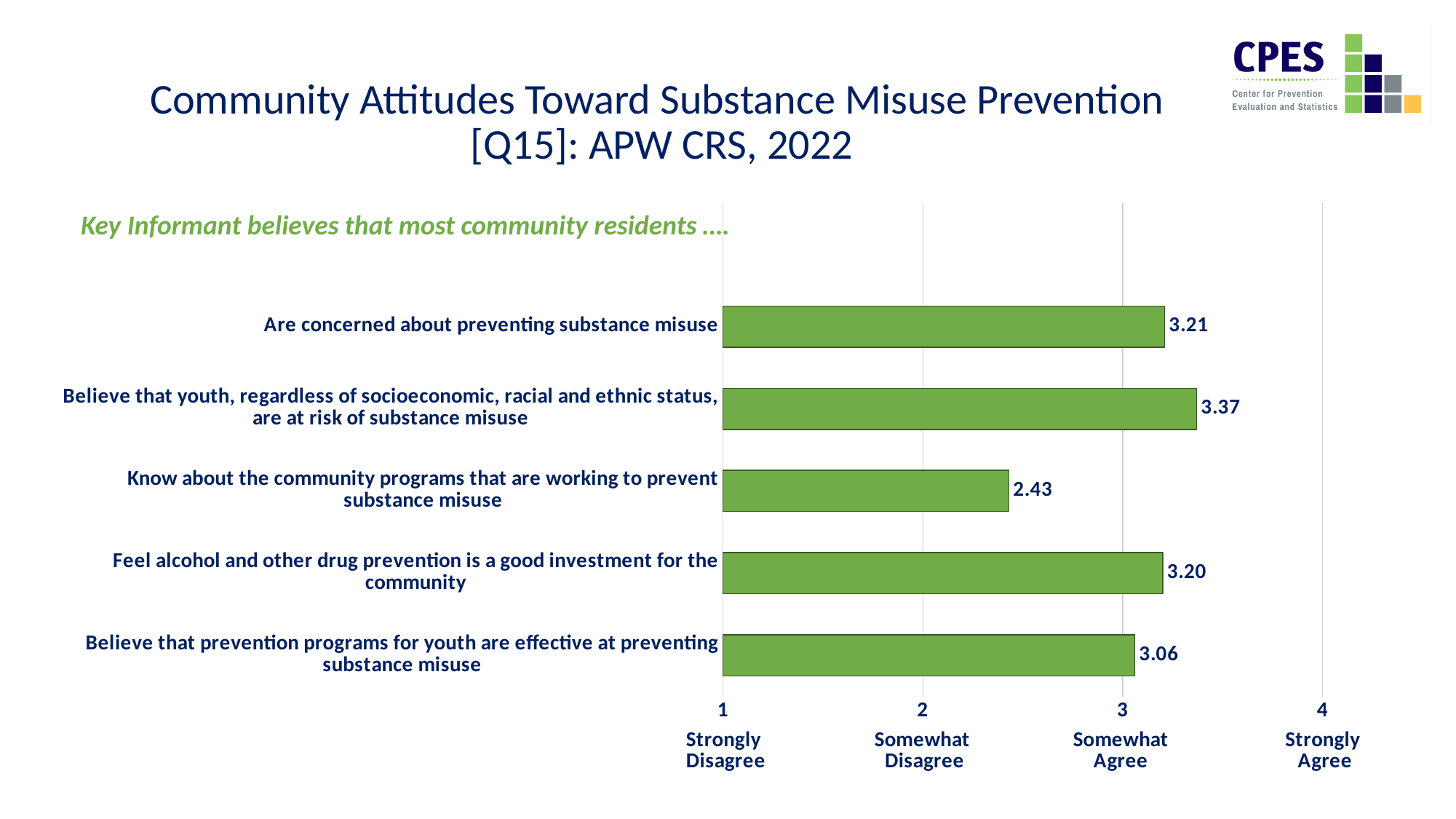
Which category has the highest value? Believe that youth, regardless of socioeconomic, racial and ethnic status, are at risk of substance misuse What kind of chart is shown on the slide? bar chart Is the value for 'Know about the community programs that are working to prevent substance misuse' greater or less than 3? less What is the difference between the values for 'Believe that youth, regardless of socioeconomic, racial and ethnic status, are at risk of substance misuse' and 'Know about the community programs that are working to prevent substance misuse'? 0.94 What is the value for 'Believe that prevention programs for youth are effective at preventing substance misuse'? 3.06 What label does the x axis show at the value 4? Strongly Agree How many categories are shown in the chart? 5 What is the value for 'Know about the community programs that are working to prevent substance misuse'? 2.43 What is the value for 'Are concerned about preventing substance misuse'? 3.21 What is the difference between the values for 'Are concerned about preventing substance misuse' and 'Feel alcohol and other drug prevention is a good investment for the community'? 0.01 Which category has the lowest value? Know about the community programs that are working to prevent substance misuse Which is larger: the value for 'Feel alcohol and other drug prevention is a good investment for the community' or the value for 'Believe that prevention programs for youth are effective at preventing substance misuse'? Feel alcohol and other drug prevention is a good investment for the community